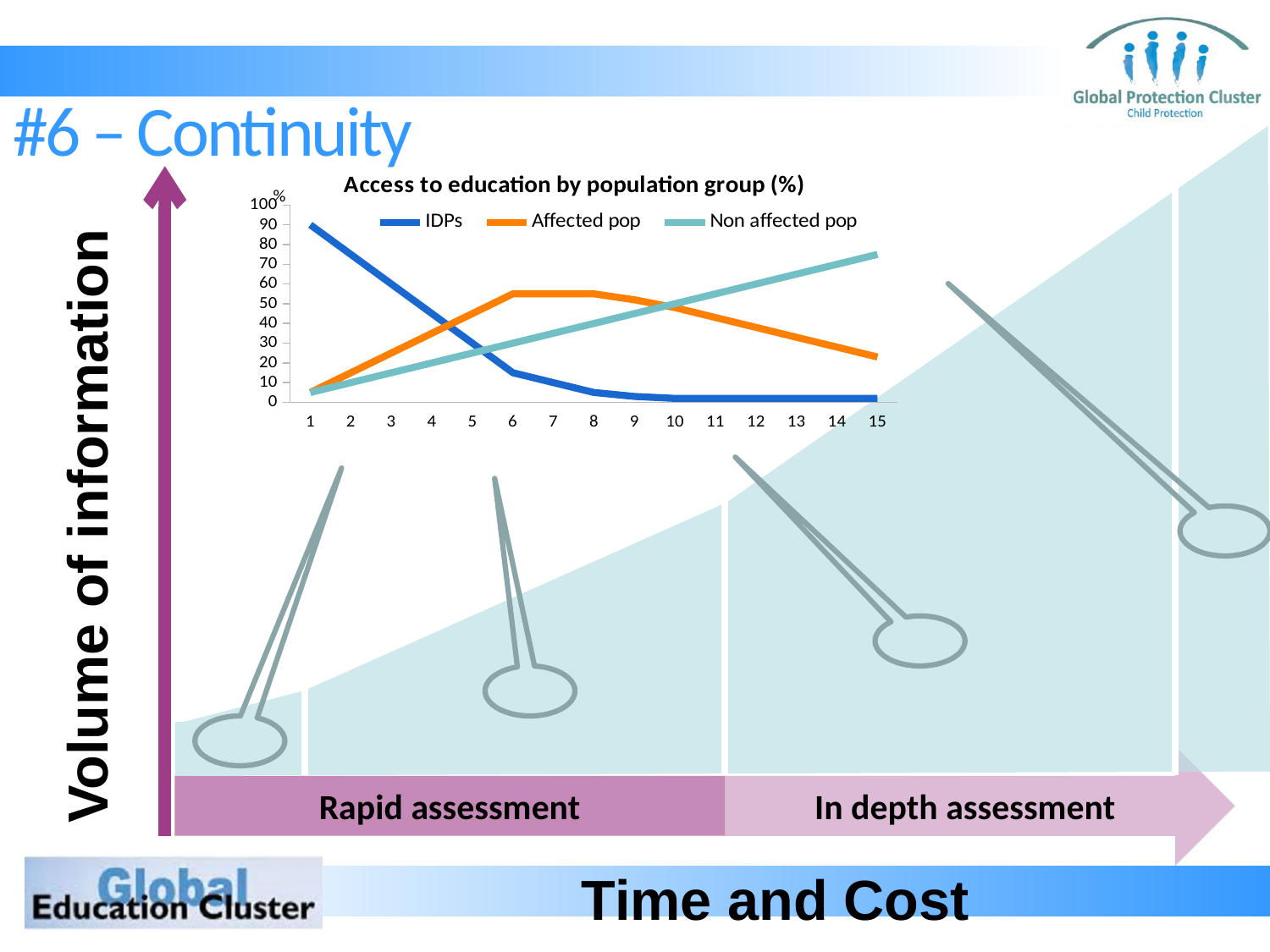
Is the value for Non affected pop at point 15 greater or less than 70? greater At point 1, which is larger: IDPs or Affected pop? IDPs What kind of chart is shown on the slide? line chart Is the value for IDPs at point 15 greater or less than 10? less Do the values for IDPs rise or fall along the x axis? fall Is the value for Affected pop at point 15 greater or less than 30? less Which series are listed in the chart's legend? IDPs, Affected pop, Non affected pop How many points are on the x axis of the chart? 15 How many series does the legend of the chart list? 3 Do the values for Non affected pop rise or fall along the x axis? rise What is the title of the chart? Access to education by population group (%)